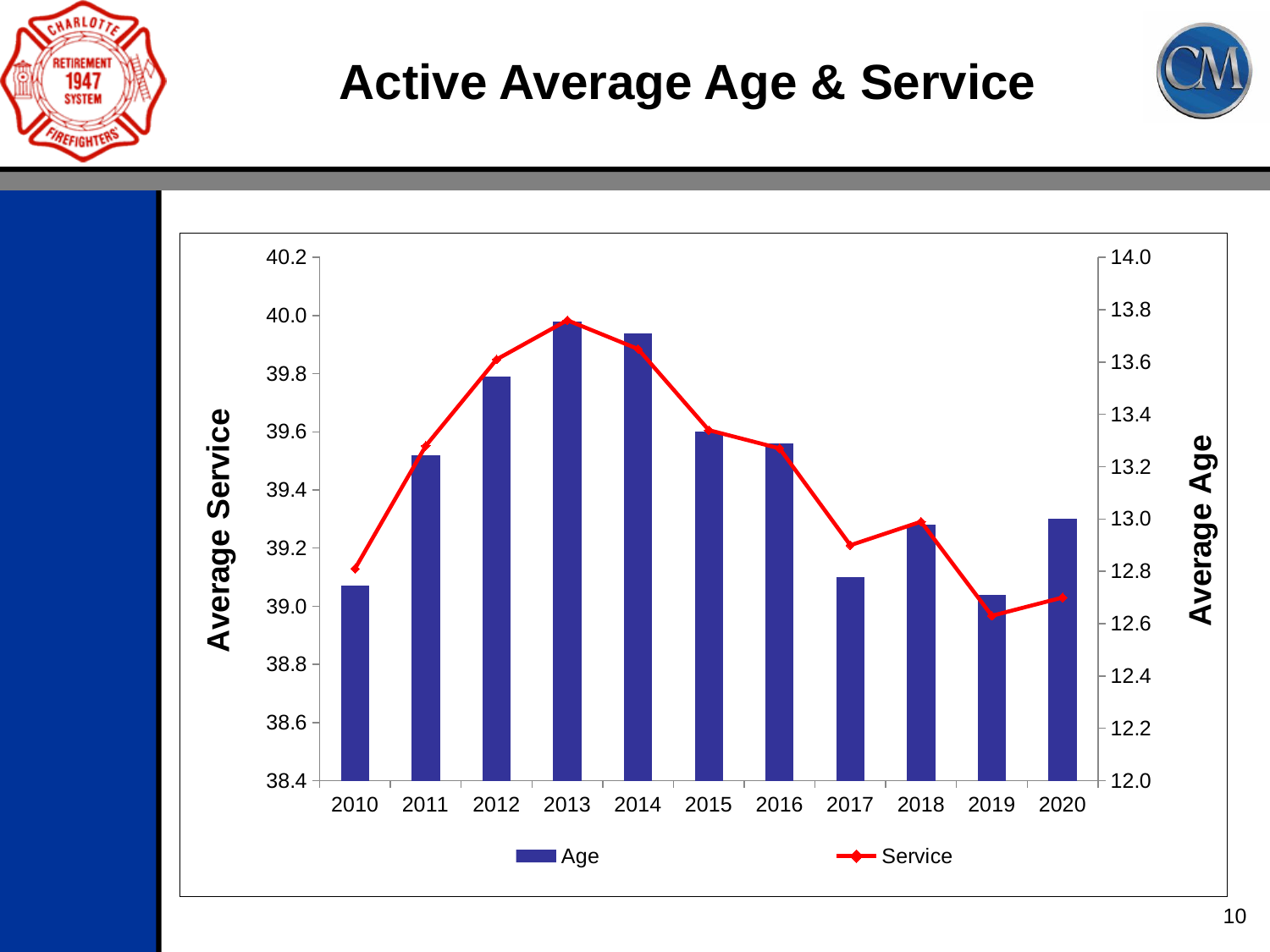
Is the Age bar for 2010 greater or less than 39.2? less Is the Service value for 2013 greater or less than 13.6? greater Which year has the higher Service value, 2012 or 2018? 2012 Does the Service line rise or fall from 2010 to 2013? rise What kind of chart is shown on the slide? A combination bar and line chart Is the Age bar for 2013 greater or less than 39.8? greater How many years are shown along the x axis of the chart? 11 How many series does the chart's legend list? 2 Which series is drawn as a red line with diamond markers? Service Which year has the taller Age bar, 2011 or 2017? 2011 In which year does the Service line reach its highest point? 2013